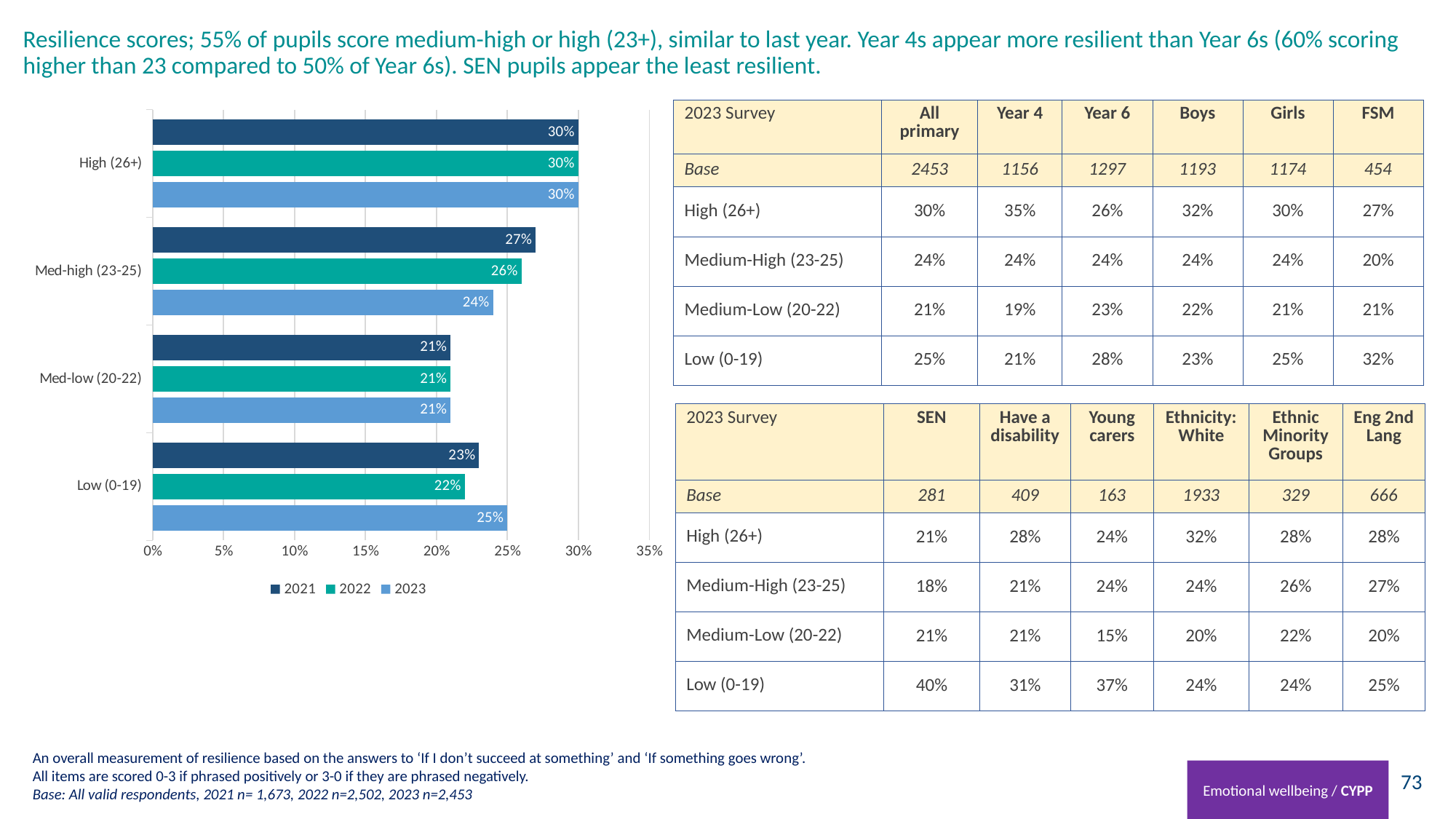
What kind of chart is shown on the slide? bar chart What are the series names listed in the legend? 2021, 2022, 2023 What is the difference between the 2021 and 2023 values for Med-high (23-25)? 3% What is the 2021 value for Low (0-19)? 23% What is the 2022 value for Med-high (23-25)? 26% What is the 2023 value for Med-high (23-25)? 24% Is the 2021 value for Med-high (23-25) greater or less than 25%? greater Which category has the lowest 2021 value? Med-low (20-22) Which is larger for Low (0-19): the 2022 value or the 2023 value? 2023 How many categories are shown on the chart? 4 How many series does the legend list? 3 Which category has the highest 2023 value? High (26+)